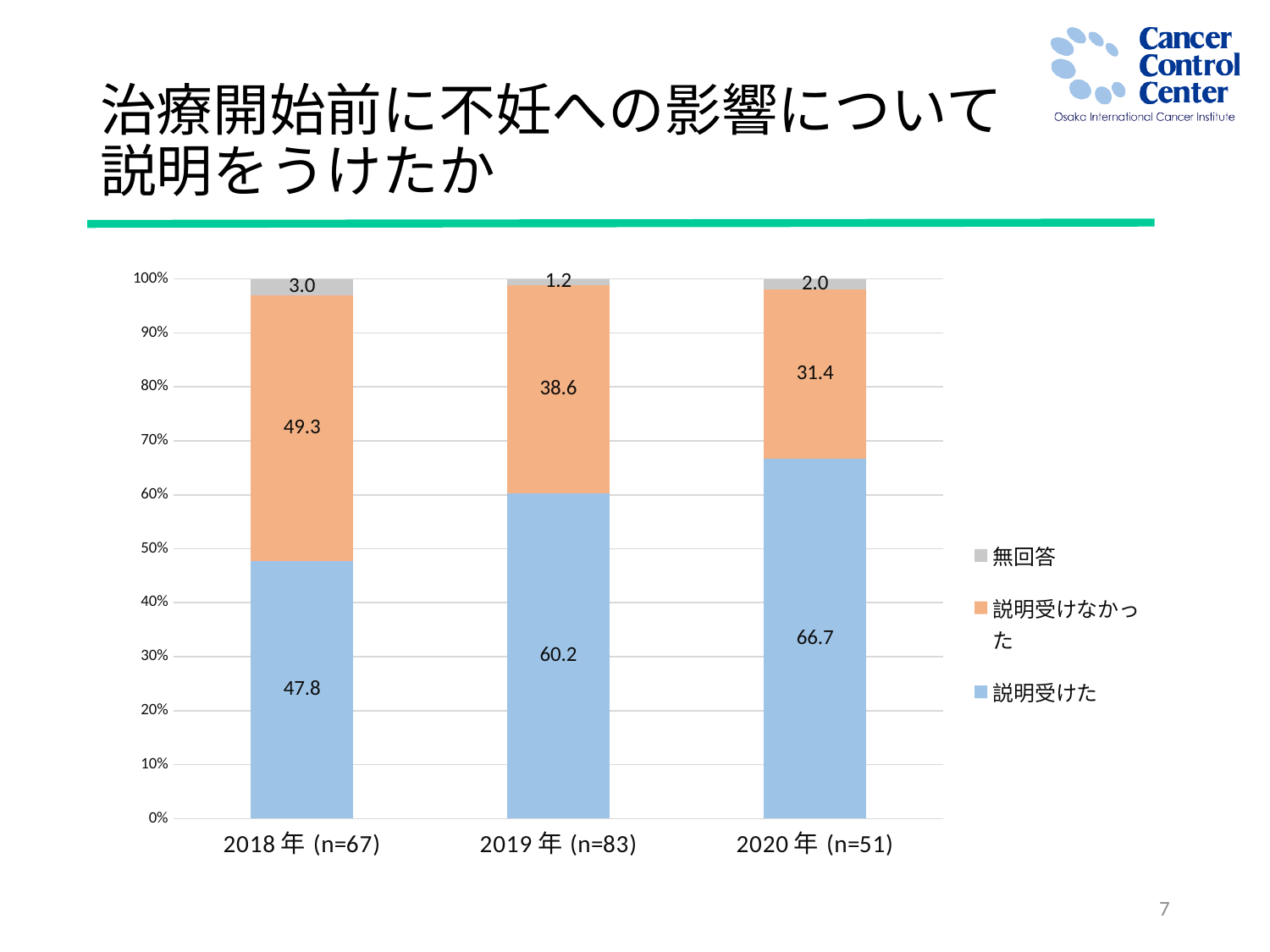
What kind of chart is shown on the slide? Stacked bar chart Which year has the highest value for 説明受けた? 2020年 (n=51) How many series does the legend list? 3 Which year has the lowest value for 無回答? 2019年 (n=83) Does the value for 説明受けた rise or fall from 2018年 to 2020年? Rise What is the value for 説明受けなかった in 2019年 (n=83)? 38.6 What is the difference between the 説明受けた values for 2020年 (n=51) and 2018年 (n=67)? 18.9 What is the value for 説明受けた in 2018年 (n=67)? 47.8 Which is larger: 説明受けなかった in 2018年 (n=67) or in 2020年 (n=51)? 2018年 (n=67) Which legend entry is shown in orange? 説明受けなかった What is the value for 無回答 in 2020年 (n=51)? 2.0 How many year categories are shown on the x axis? 3